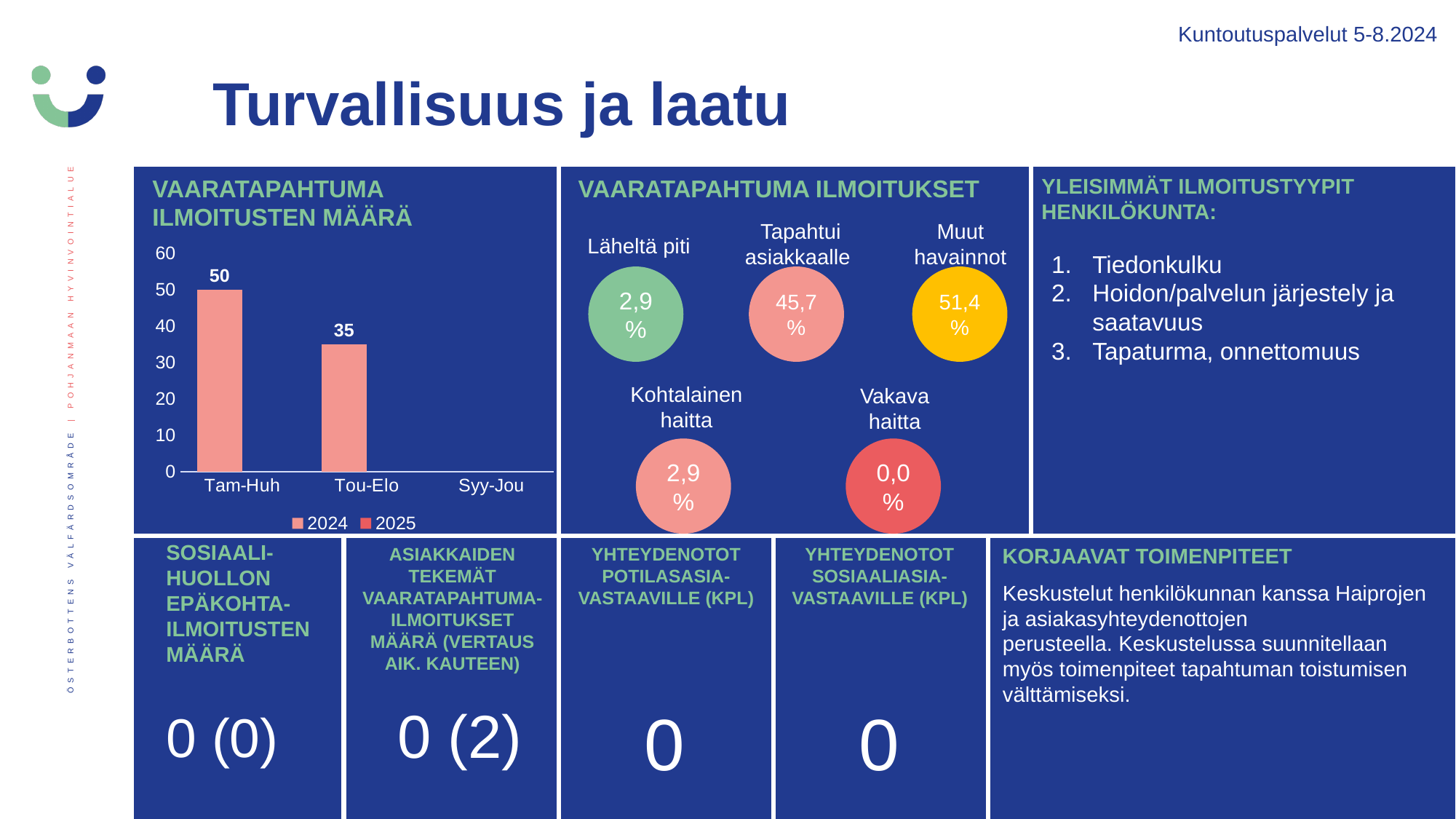
In the chart 'VAARATAPAHTUMA ILMOITUSTEN MÄÄRÄ', what is the difference between the values for Tam-Huh and Tou-Elo? 15 How many series does the legend of the chart 'VAARATAPAHTUMA ILMOITUSTEN MÄÄRÄ' list? 2 In the chart 'VAARATAPAHTUMA ILMOITUSTEN MÄÄRÄ', is the value for Tam-Huh greater or less than 40? greater In the chart 'VAARATAPAHTUMA ILMOITUSTEN MÄÄRÄ', what is the value for Tou-Elo? 35 In the chart 'VAARATAPAHTUMA ILMOITUSTEN MÄÄRÄ', what is the value for Tam-Huh? 50 In the chart 'VAARATAPAHTUMA ILMOITUSTEN MÄÄRÄ', which category has the highest value? Tam-Huh In the chart 'VAARATAPAHTUMA ILMOITUSTEN MÄÄRÄ', which is larger, the value for Tam-Huh or Tou-Elo? Tam-Huh How many categories are shown on the x axis of the chart 'VAARATAPAHTUMA ILMOITUSTEN MÄÄRÄ'? 3 In the chart 'VAARATAPAHTUMA ILMOITUSTEN MÄÄRÄ', do the values rise or fall from Tam-Huh to Tou-Elo? fall What are the legend entries of the chart 'VAARATAPAHTUMA ILMOITUSTEN MÄÄRÄ'? 2024 and 2025 What kind of chart is 'VAARATAPAHTUMA ILMOITUSTEN MÄÄRÄ'? bar chart In the chart 'VAARATAPAHTUMA ILMOITUSTEN MÄÄRÄ', is the value for Tou-Elo greater or less than 40? less